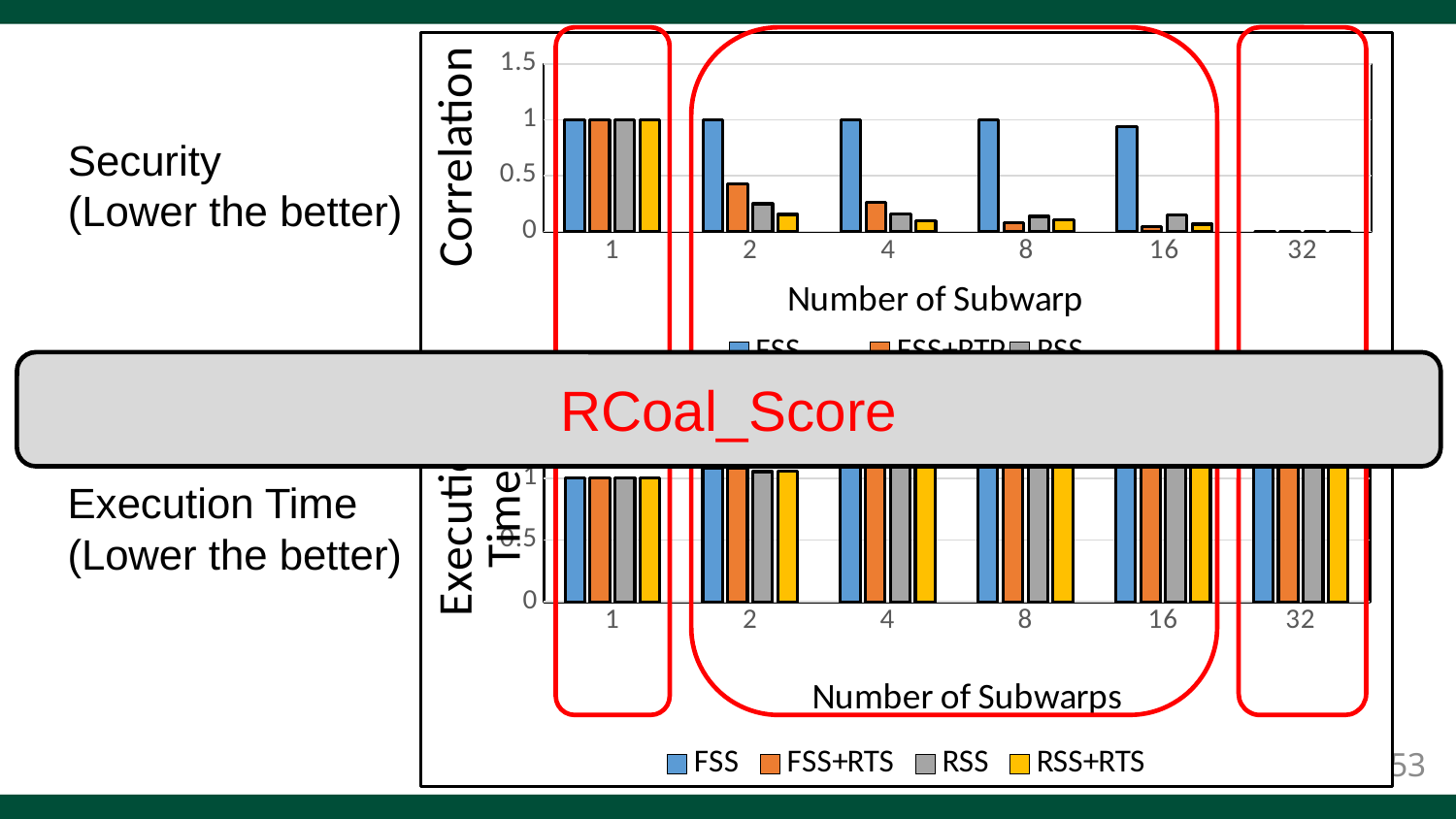
In the top Correlation chart, is the value for FSS at 2 subwarps greater or less than 0.5? greater What kind of chart is the top chart (Correlation)? bar chart In the bottom Execution Time chart, is the value for FSS at 1 subwarp greater or less than 0.5? greater In the top Correlation chart, is the value for RSS at 16 subwarps greater or less than 0.5? less In the bottom Execution Time chart, how many series does the legend list? 4 In the top Correlation chart, which series has the highest value at 8 subwarps? FSS In the top Correlation chart, how many Number of Subwarp categories are shown on the x axis? 6 What is the x-axis title of the bottom Execution Time chart? Number of Subwarps